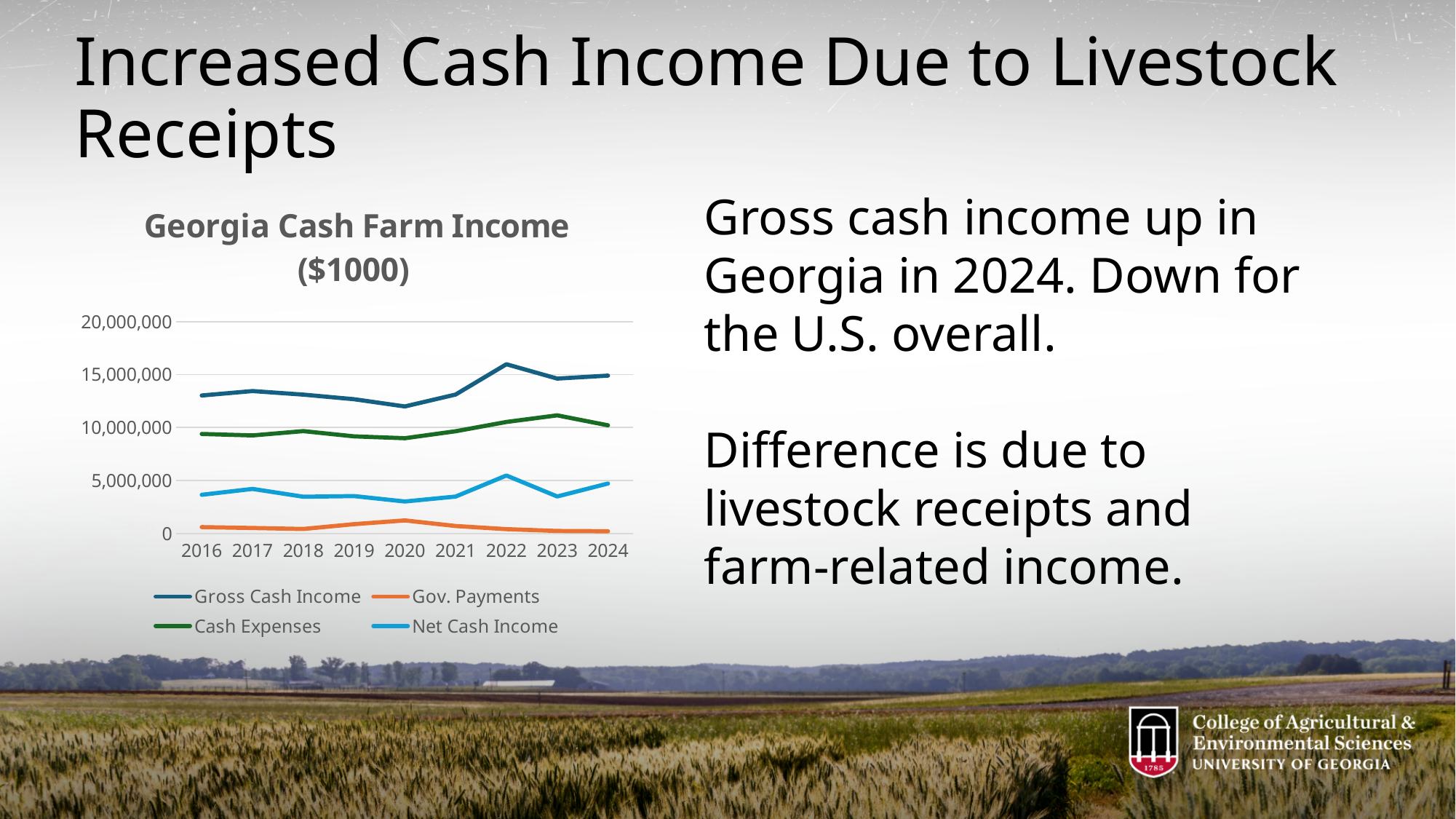
In which year does Gross Cash Income reach its highest value? 2022 How many years are shown on the x axis of the chart? 9 What is the title of the chart? Georgia Cash Farm Income ($1000) What kind of chart is shown on the slide? line chart Is the value for Cash Expenses in 2023 greater or less than 10,000,000? greater Which is larger in 2024, Gross Cash Income or Cash Expenses? Gross Cash Income How many series does the legend of the Georgia Cash Farm Income chart list? 4 Is the value for Net Cash Income in 2022 greater or less than 5,000,000? greater Is the value for Gross Cash Income in 2020 greater or less than 15,000,000? less In which year do Gov. Payments peak? 2020 In which year is Gross Cash Income at its lowest? 2020